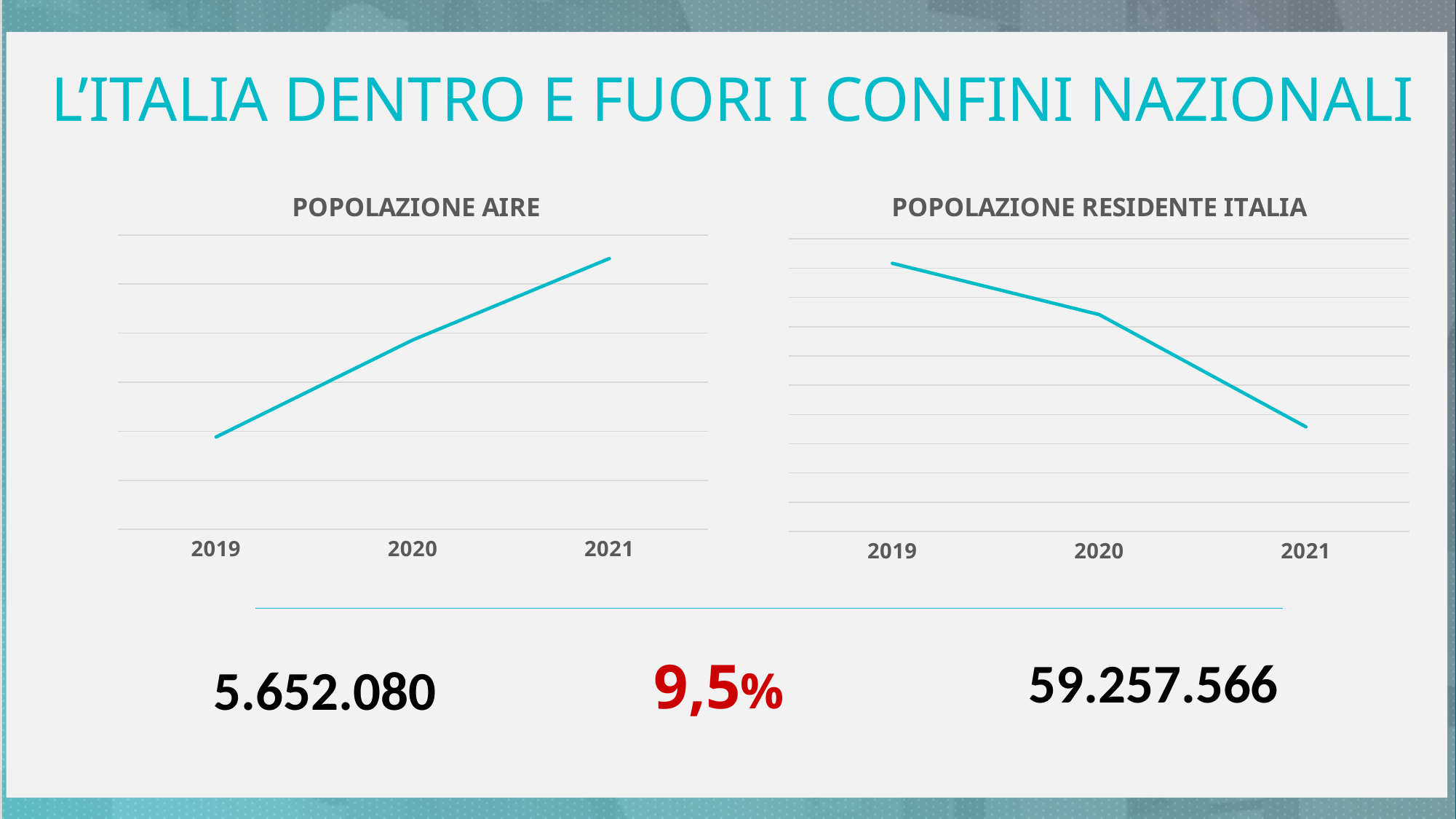
What kind of chart is the "POPOLAZIONE AIRE" chart? line chart How many years are shown on the x axis of the "POPOLAZIONE RESIDENTE ITALIA" chart? 3 What kind of chart is the "POPOLAZIONE RESIDENTE ITALIA" chart? line chart How many points are plotted on the "POPOLAZIONE AIRE" chart? 3 In the "POPOLAZIONE RESIDENTE ITALIA" chart, is the value for 2020 larger or smaller than the value for 2021? larger In the "POPOLAZIONE AIRE" chart, do the values rise or fall from 2019 to 2021? rise In the "POPOLAZIONE RESIDENTE ITALIA" chart, which year has the lowest value? 2021 In the "POPOLAZIONE AIRE" chart, which year has the lowest value? 2019 In the "POPOLAZIONE RESIDENTE ITALIA" chart, which year has the highest value? 2019 In the "POPOLAZIONE AIRE" chart, which year has the highest value? 2021 In the "POPOLAZIONE RESIDENTE ITALIA" chart, do the values rise or fall from 2019 to 2021? fall What is the title of the chart on the left side of the slide? POPOLAZIONE AIRE